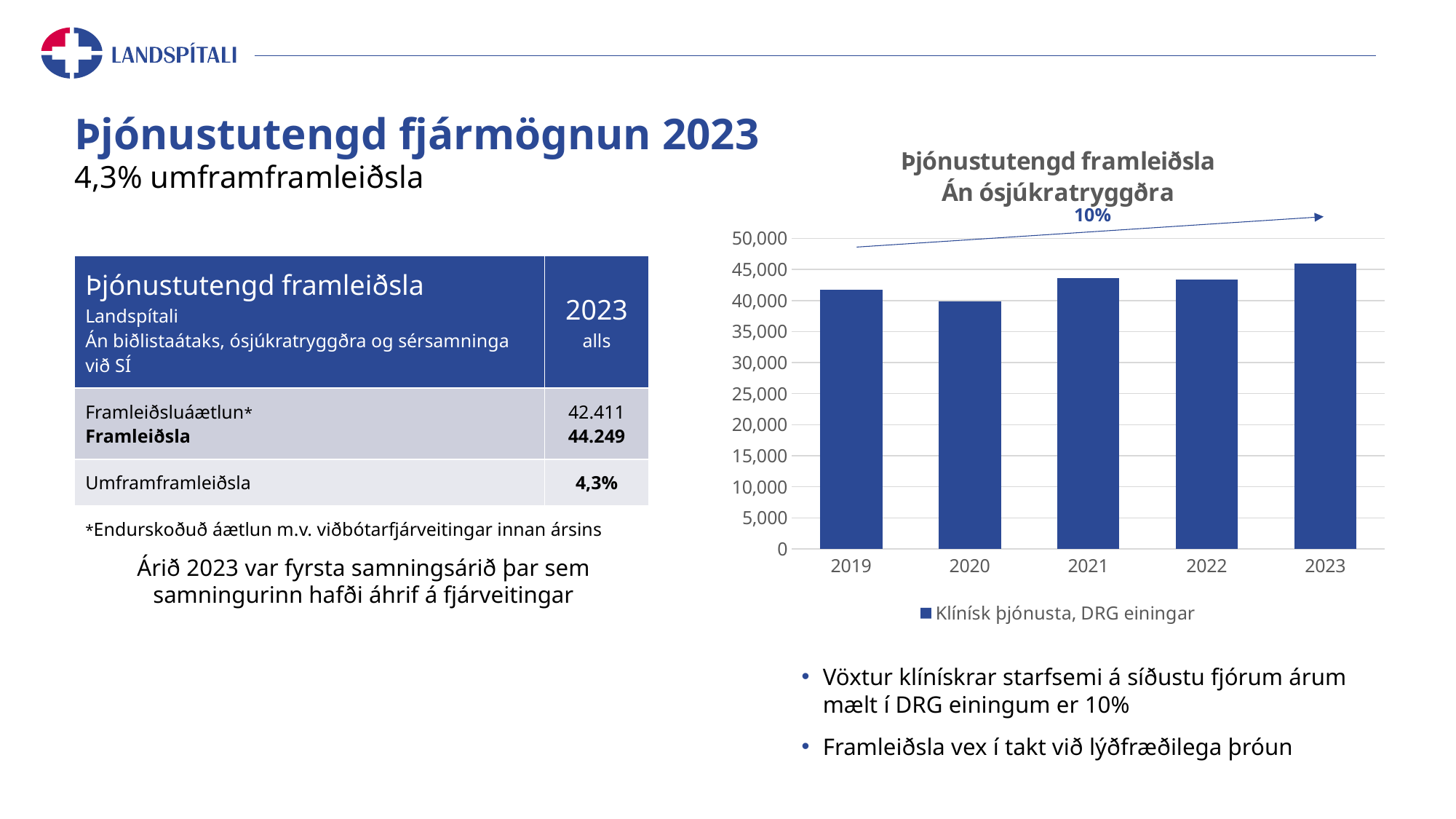
What is the legend entry of the chart? Klínísk þjónusta, DRG einingar Which year has the highest value in the chart? 2023 What percentage growth is annotated above the bars in the chart? 10% Is the value for 2021 greater or less than 45,000? less Which year has the lowest value in the chart? 2020 How many series does the chart legend list? 1 How many years are shown on the x axis of the chart? 5 Which is larger, the value for 2021 or the value for 2020? 2021 What kind of chart is shown on the slide? Bar chart Is the value for 2019 greater or less than 40,000? greater Is the value for 2020 greater or less than 35,000? greater